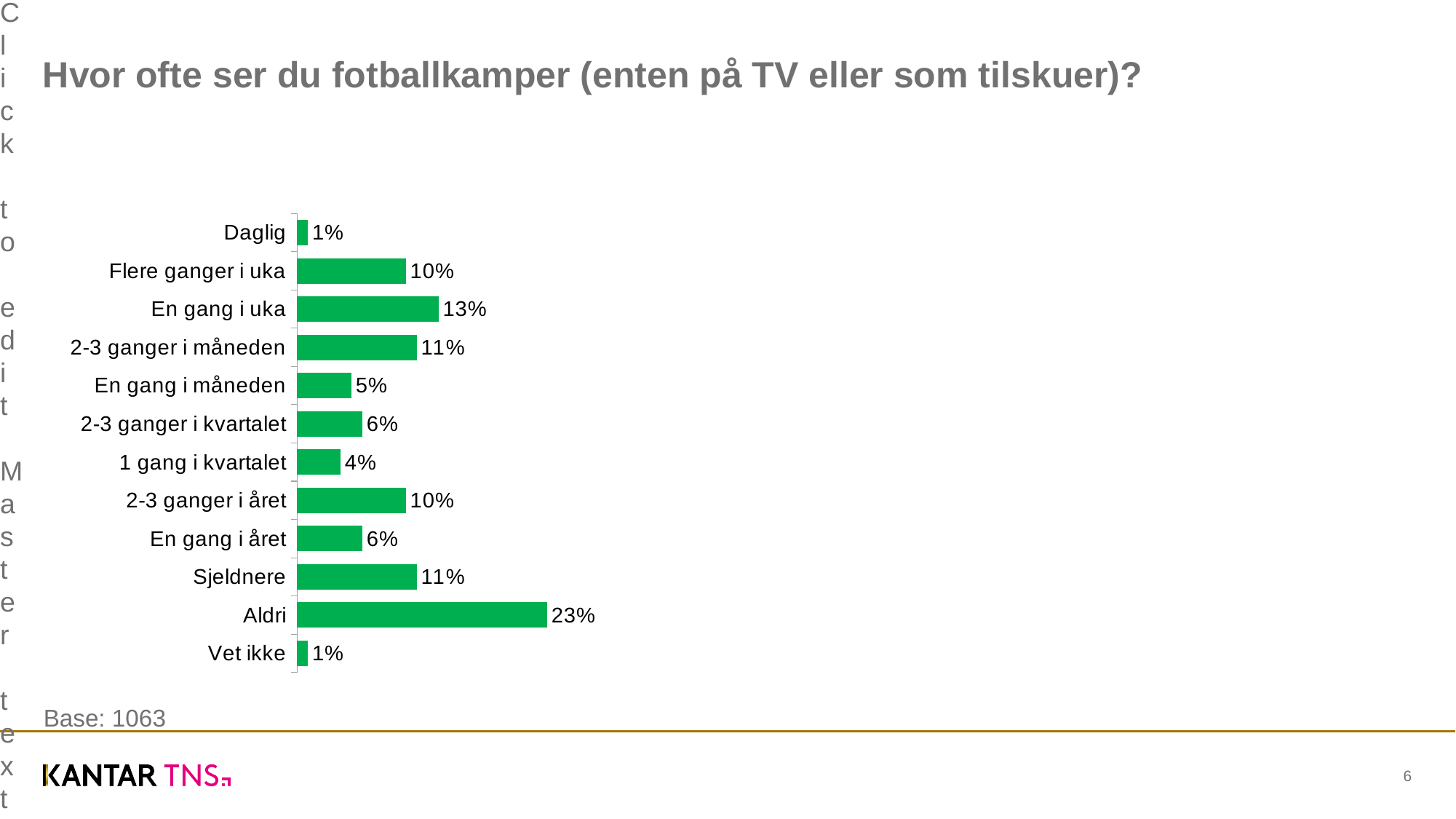
How many categories are shown in the chart? 12 What is the difference between the values for "Flere ganger i uka" and "En gang i måneden"? 5% Which is larger, the value for "Sjeldnere" or the value for "En gang i året"? Sjeldnere Which is larger, the value for "2-3 ganger i måneden" or the value for "1 gang i kvartalet"? 2-3 ganger i måneden What is the difference between the values for "Aldri" and "En gang i uka"? 10% What kind of chart is shown on the slide? Bar chart What is the base (number of respondents) stated on the slide? 1063 What is the value for "En gang i uka"? 13% Which category has the highest value? Aldri What is the value for "2-3 ganger i kvartalet"? 6% What is the value for "Aldri"? 23% What colour are the bars in the chart? Green